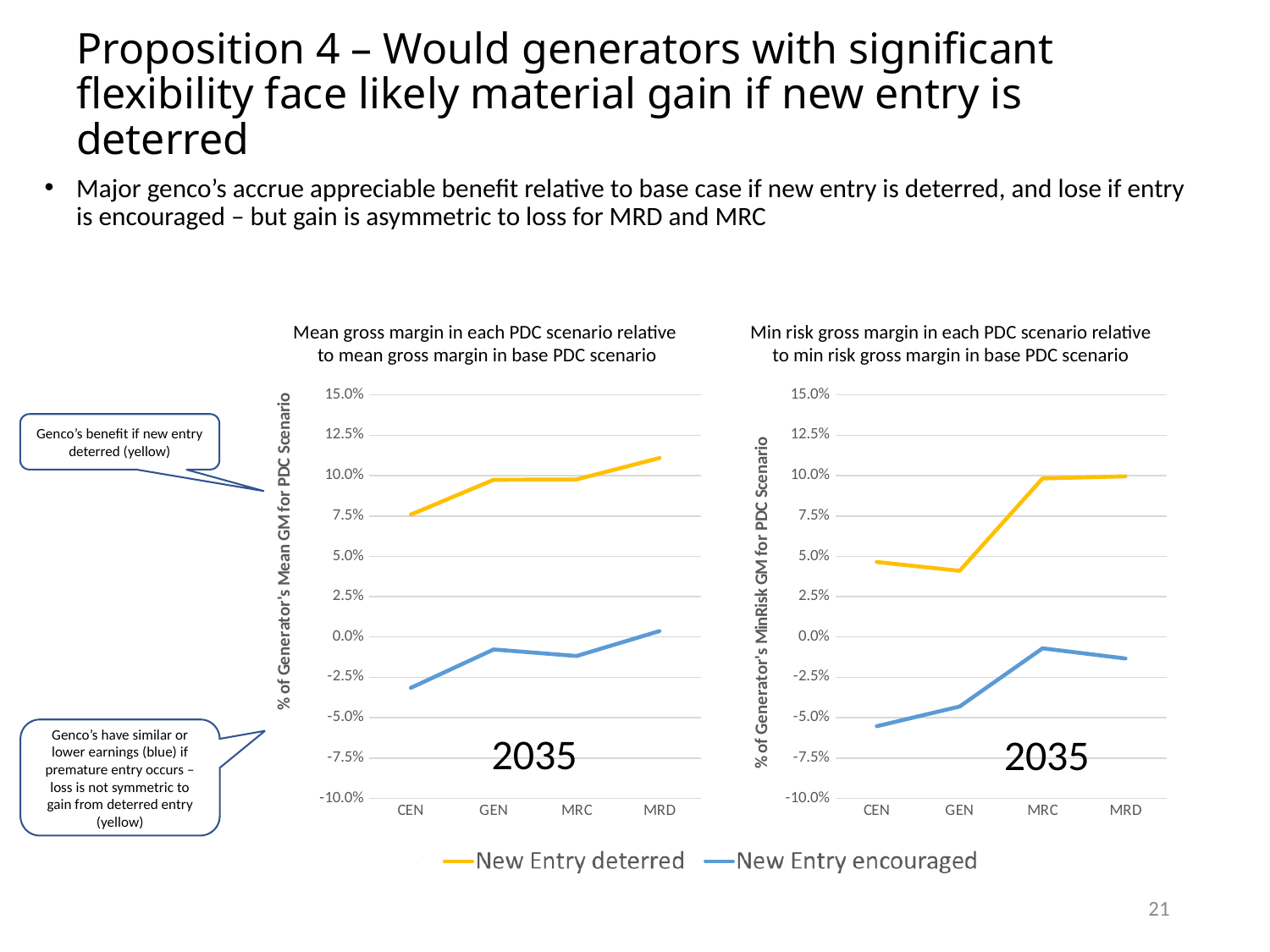
In the left chart, 'Mean gross margin in each PDC scenario relative to mean gross margin in base PDC scenario', is the New Entry deterred value for MRD greater or less than 10.0%? greater In the right chart, 'Min risk gross margin in each PDC scenario relative to min risk gross margin in base PDC scenario', how many categories are shown on the x axis? 4 What year is labelled inside both charts? 2035 In the left chart, 'Mean gross margin in each PDC scenario relative to mean gross margin in base PDC scenario', which category has the lowest value for New Entry deterred? CEN In the right chart, 'Min risk gross margin in each PDC scenario relative to min risk gross margin in base PDC scenario', which category has the lowest value for New Entry encouraged? CEN In the right chart, 'Min risk gross margin in each PDC scenario relative to min risk gross margin in base PDC scenario', which is larger for New Entry deterred: MRC or CEN? MRC In the left chart, 'Mean gross margin in each PDC scenario relative to mean gross margin in base PDC scenario', which category has the highest value for New Entry deterred? MRD In the left chart, 'Mean gross margin in each PDC scenario relative to mean gross margin in base PDC scenario', is the New Entry encouraged value for CEN greater or less than -2.5%? less What kind of chart is the left chart, 'Mean gross margin in each PDC scenario relative to mean gross margin in base PDC scenario'? Line chart In the right chart, 'Min risk gross margin in each PDC scenario relative to min risk gross margin in base PDC scenario', is the New Entry deterred value for GEN greater or less than 5.0%? less In the left chart, 'Mean gross margin in each PDC scenario relative to mean gross margin in base PDC scenario', does the New Entry deterred line generally rise or fall from CEN to MRD? Rise How many series does the shared legend below the charts list? 2